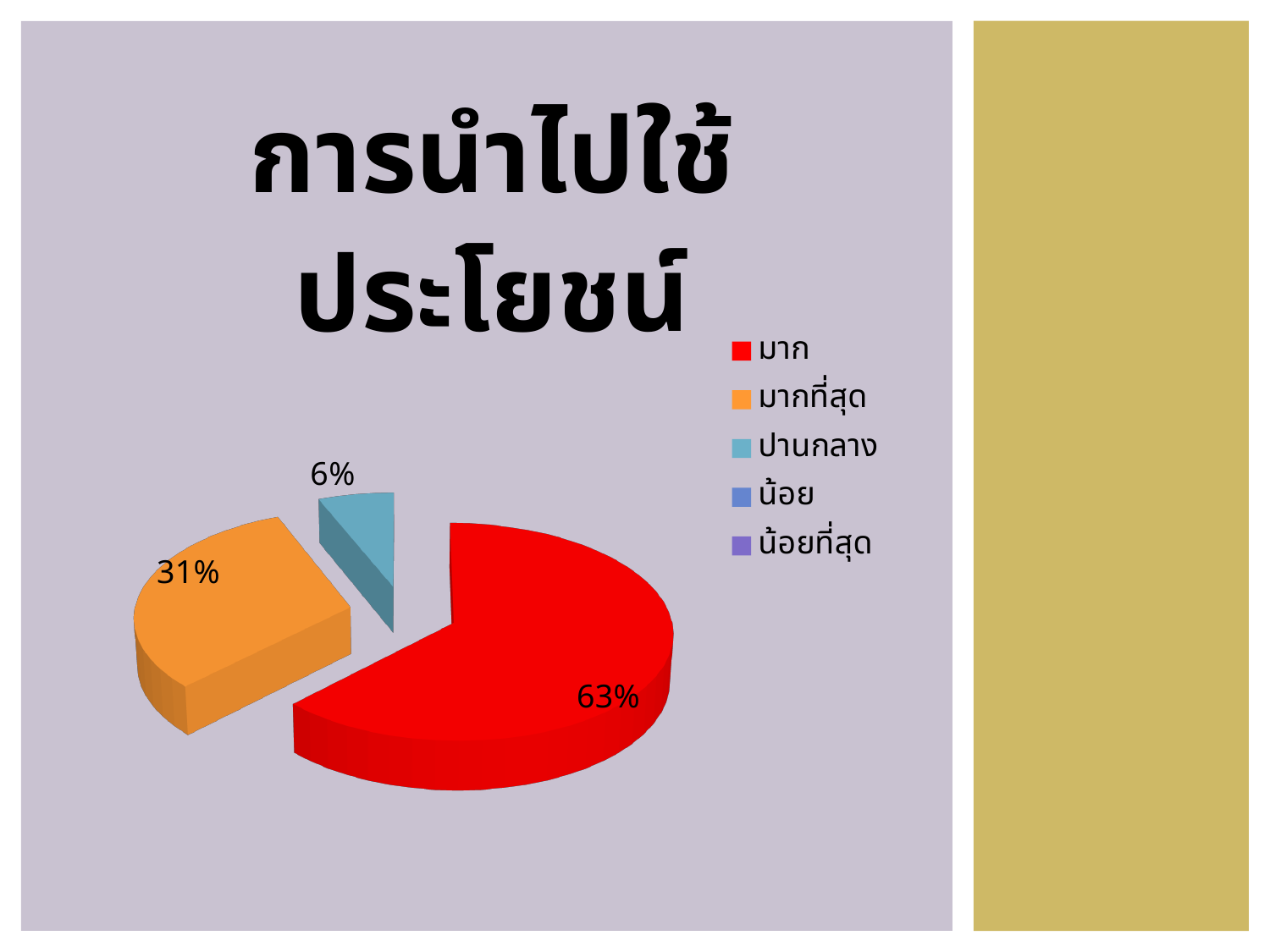
What colour is the slice for มาก? red Which category has the largest share of the pie? มาก What percentage is shown for the ปานกลาง slice? 6% Which is larger, the share for มากที่สุด or the share for ปานกลาง? มากที่สุด How many categories does the legend list? 5 What kind of chart is shown on the slide? pie chart What percentage is shown for the มากที่สุด slice? 31% What is the title of the chart? การนำไปใช้ประโยชน์ How many slices have a percentage label printed on the chart? 3 What percentage is shown for the มาก slice? 63% What is the difference in percentage points between the มาก slice and the มากที่สุด slice? 32 Of the slices with a printed label, which category has the smallest share? ปานกลาง